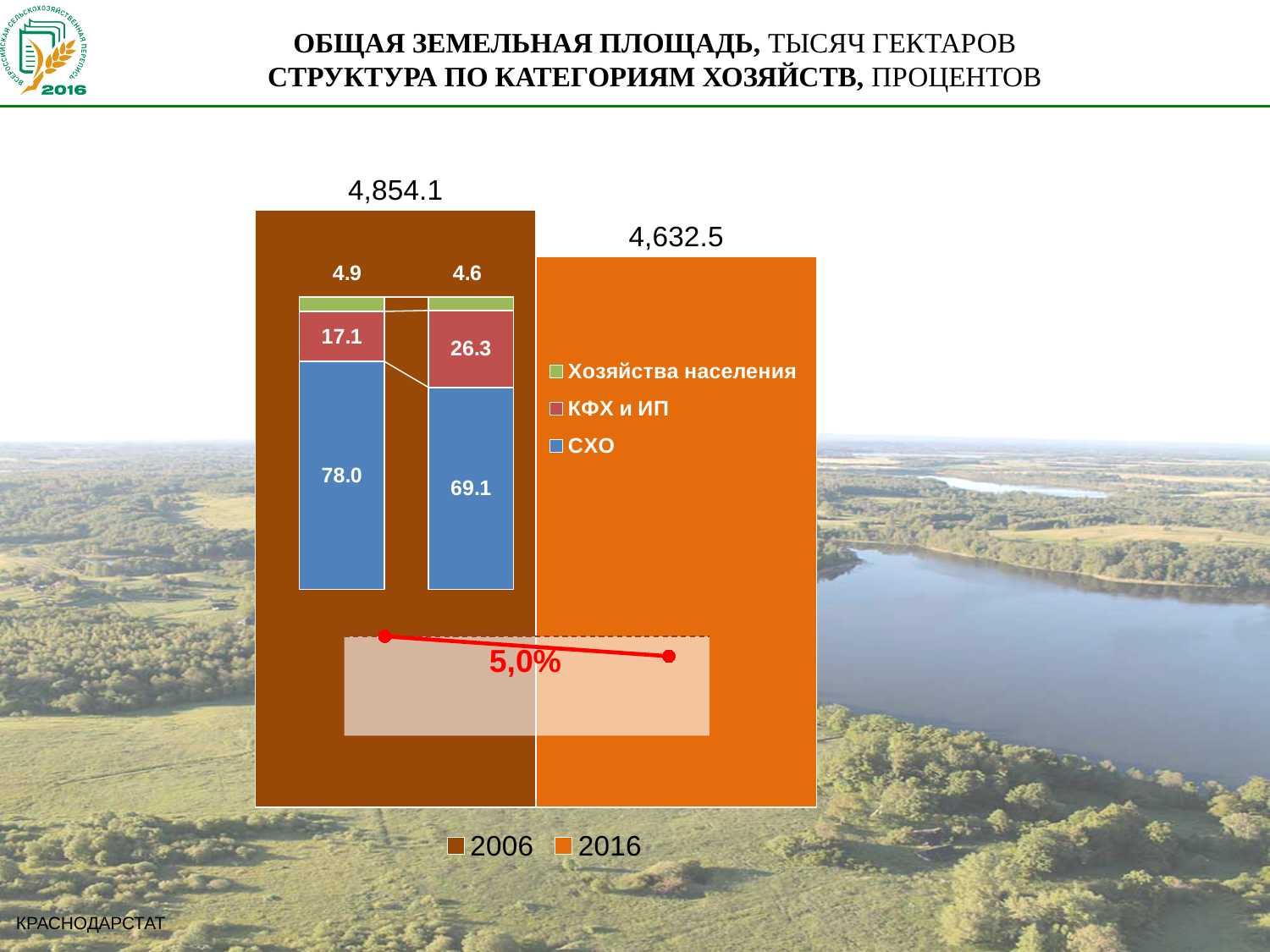
In the inset stacked bar chart of structure by category, what is the share of Хозяйства населения in 2006? 4.9 In the inset stacked bar chart of structure by category, what is the share of КФХ и ИП in 2016? 26.3 In the large bar chart of total land area, how many years are shown in the legend? 2 What kind of chart is the inset chart of structure by category? stacked bar chart In the inset stacked bar chart of structure by category, what is the share of СХО in 2006? 78.0 In the large bar chart of total land area, what is the value for 2006? 4,854.1 In the inset stacked bar chart of structure by category, by how much did the share of КФХ и ИП change from 2006 to 2016? 9.2 In the inset stacked bar chart of structure by category, which category has the smallest share in 2016? Хозяйства населения In the inset stacked bar chart of structure by category, how many categories does the legend list? 3 In the large bar chart of total land area, what is the value for 2016? 4,632.5 In the inset stacked bar chart of structure by category, what is the share of СХО in 2016? 69.1 In the large bar chart of total land area, which year has the larger value, 2006 or 2016? 2006